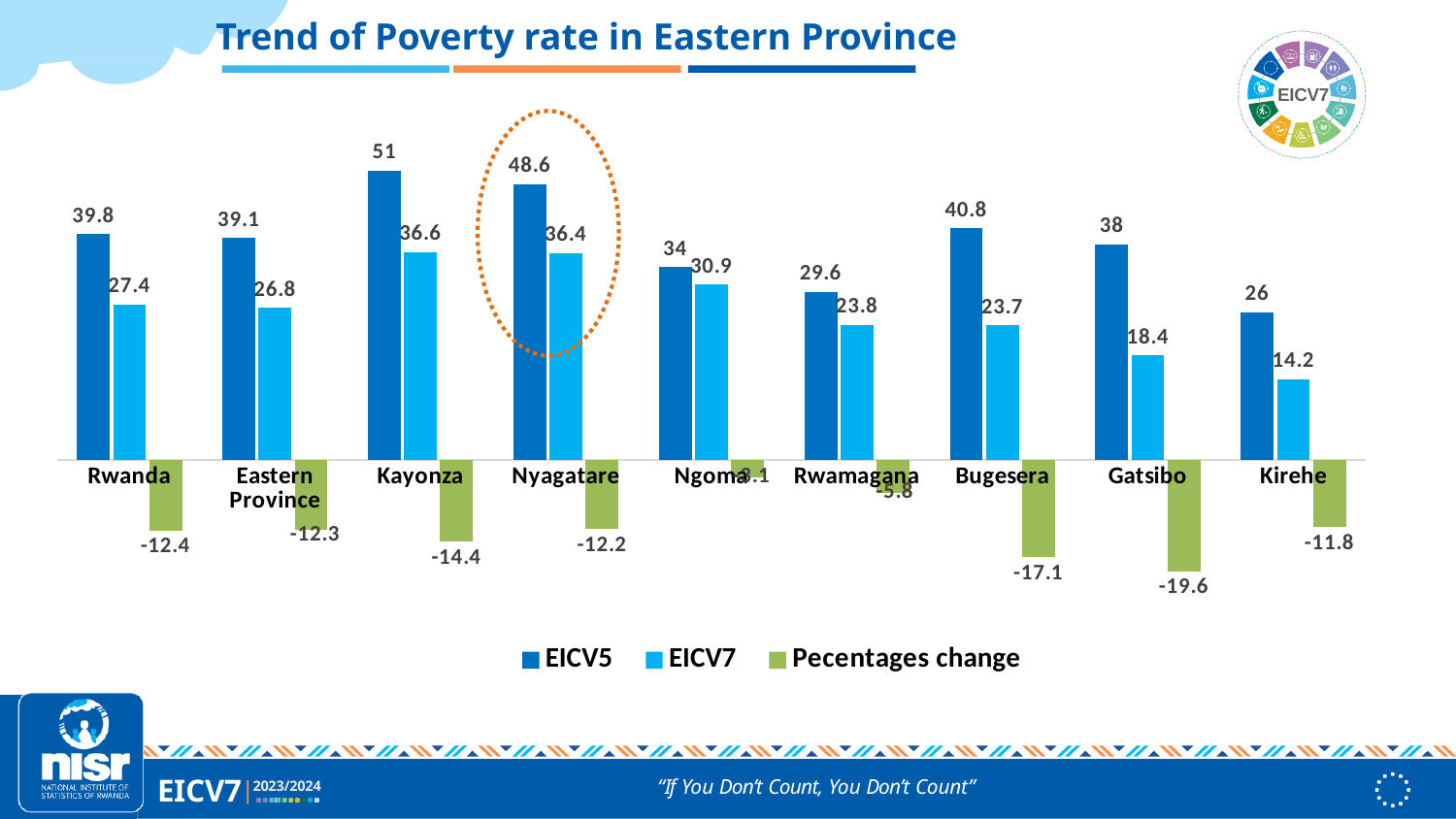
What is the percentage change shown for Gatsibo? -19.6 How many categories are shown on the x axis? 9 What is the EICV7 poverty rate for Kirehe? 14.2 What is the EICV7 poverty rate for Nyagatare? 36.4 What is the EICV5 poverty rate for Kayonza? 51 Which category is highlighted with a dotted orange circle? Nyagatare What is the difference between the EICV5 and EICV7 poverty rates for Bugesera? 17.1 Which category has the lowest EICV7 poverty rate? Kirehe Which category has the highest EICV5 poverty rate? Kayonza How many series does the legend list? 3 What kind of chart is shown on the slide? Bar chart Which is larger, the EICV7 poverty rate for Ngoma or for Rwamagana? Ngoma